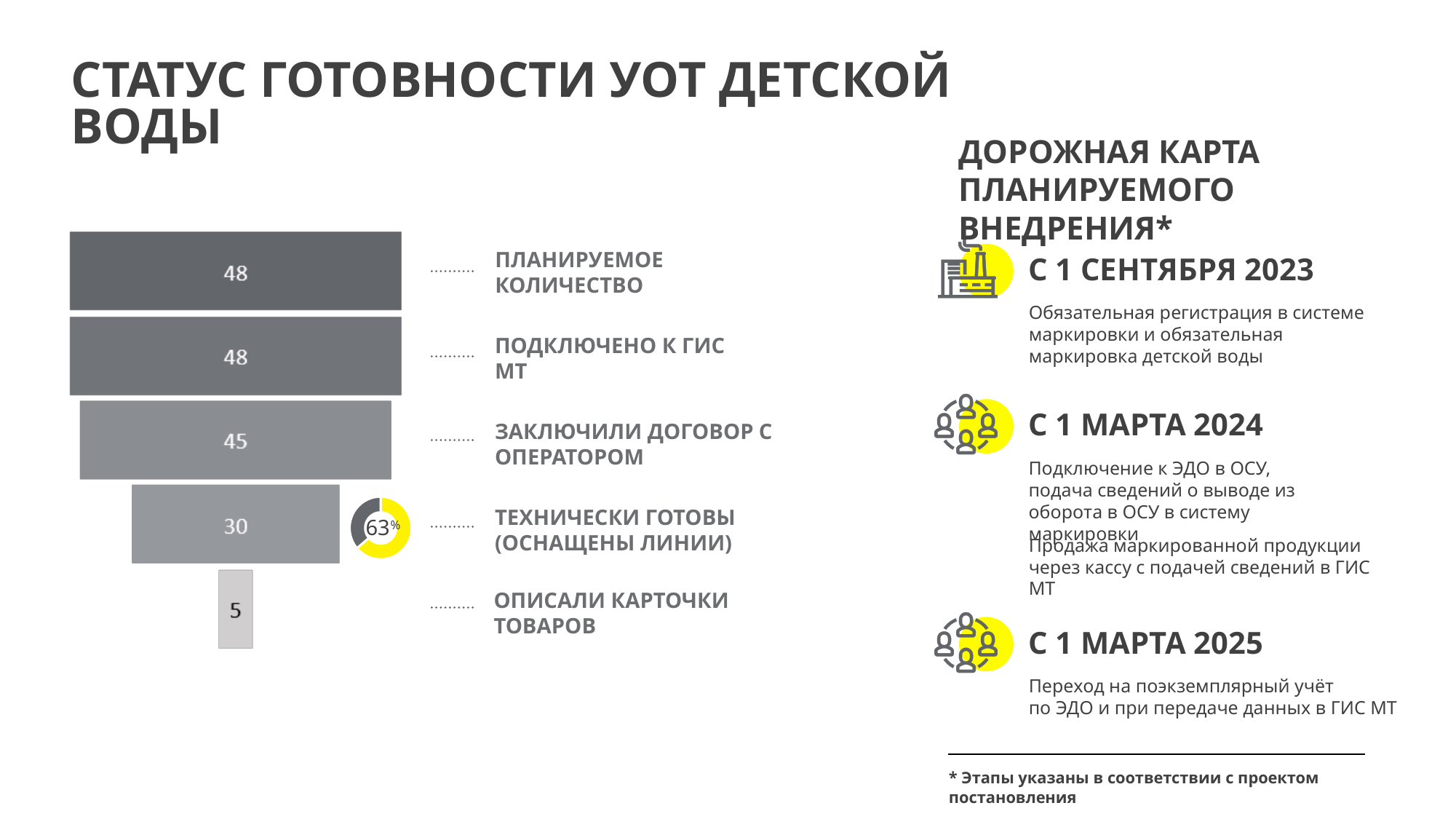
In the funnel chart, what is the value for ОПИСАЛИ КАРТОЧКИ ТОВАРОВ? 5 What kind of chart is shown on the left of the slide? Funnel chart In the funnel chart, which stage has the lowest value? ОПИСАЛИ КАРТОЧКИ ТОВАРОВ In the funnel chart, what is the value for ЗАКЛЮЧИЛИ ДОГОВОР С ОПЕРАТОРОМ? 45 In the funnel chart, which is larger: ЗАКЛЮЧИЛИ ДОГОВОР С ОПЕРАТОРОМ or ТЕХНИЧЕСКИ ГОТОВЫ (ОСНАЩЕНЫ ЛИНИИ)? ЗАКЛЮЧИЛИ ДОГОВОР С ОПЕРАТОРОМ In the funnel chart, what is the value for ПЛАНИРУЕМОЕ КОЛИЧЕСТВО? 48 In the funnel chart, what is the difference between ЗАКЛЮЧИЛИ ДОГОВОР С ОПЕРАТОРОМ and ОПИСАЛИ КАРТОЧКИ ТОВАРОВ? 40 How many stages does the funnel chart show? 5 Do the values in the funnel chart rise or fall from the top stage to the bottom stage? Fall In the funnel chart, what is the value for ТЕХНИЧЕСКИ ГОТОВЫ (ОСНАЩЕНЫ ЛИНИИ)? 30 In the funnel chart, what is the difference between ПОДКЛЮЧЕНО К ГИС МТ and ТЕХНИЧЕСКИ ГОТОВЫ (ОСНАЩЕНЫ ЛИНИИ)? 18 What percentage is shown in the small donut chart next to the ТЕХНИЧЕСКИ ГОТОВЫ (ОСНАЩЕНЫ ЛИНИИ) stage? 63%